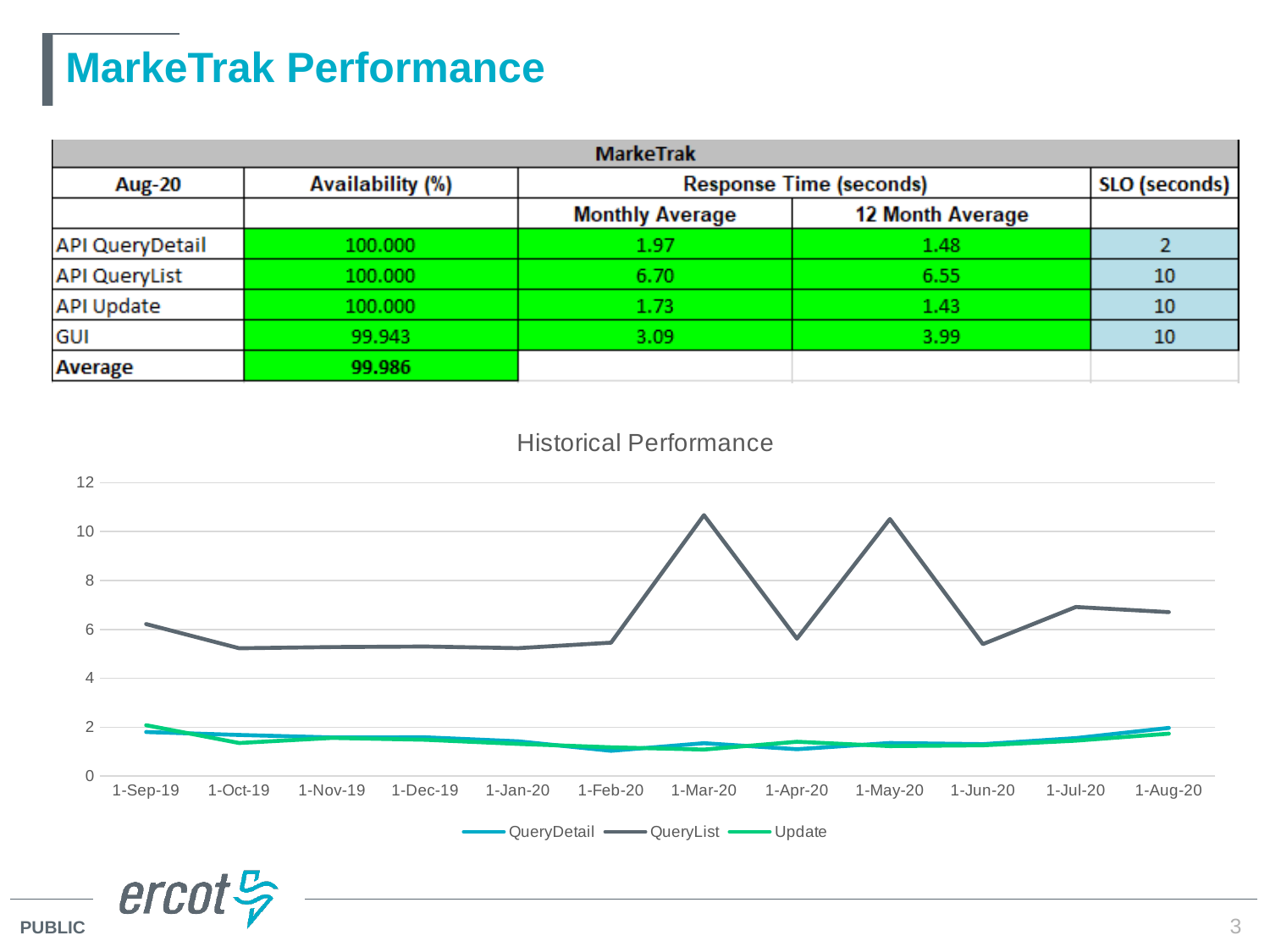
In the Historical Performance chart, is the value for QueryDetail at 1-Feb-20 greater or less than 2? less How many dates are shown on the x axis of the Historical Performance chart? 12 In the Historical Performance chart, which series has the highest values across the whole period? QueryList In the Historical Performance chart, does the QueryList line rise or fall from 1-Feb-20 to 1-Mar-20? rise In the Historical Performance chart, is the value for QueryList at 1-Mar-20 greater or less than 10? greater How many series does the legend of the Historical Performance chart list? 3 Which series are listed in the legend of the Historical Performance chart? QueryDetail, QueryList, Update In the Historical Performance chart, is the value for QueryList at 1-Oct-19 greater or less than 6? less In the Historical Performance chart, does the QueryList line rise or fall from 1-May-20 to 1-Jun-20? fall What is the title of the line chart on the slide? Historical Performance In the Historical Performance chart, which is larger at 1-Mar-20: QueryList or QueryDetail? QueryList What kind of chart is the Historical Performance chart? line chart